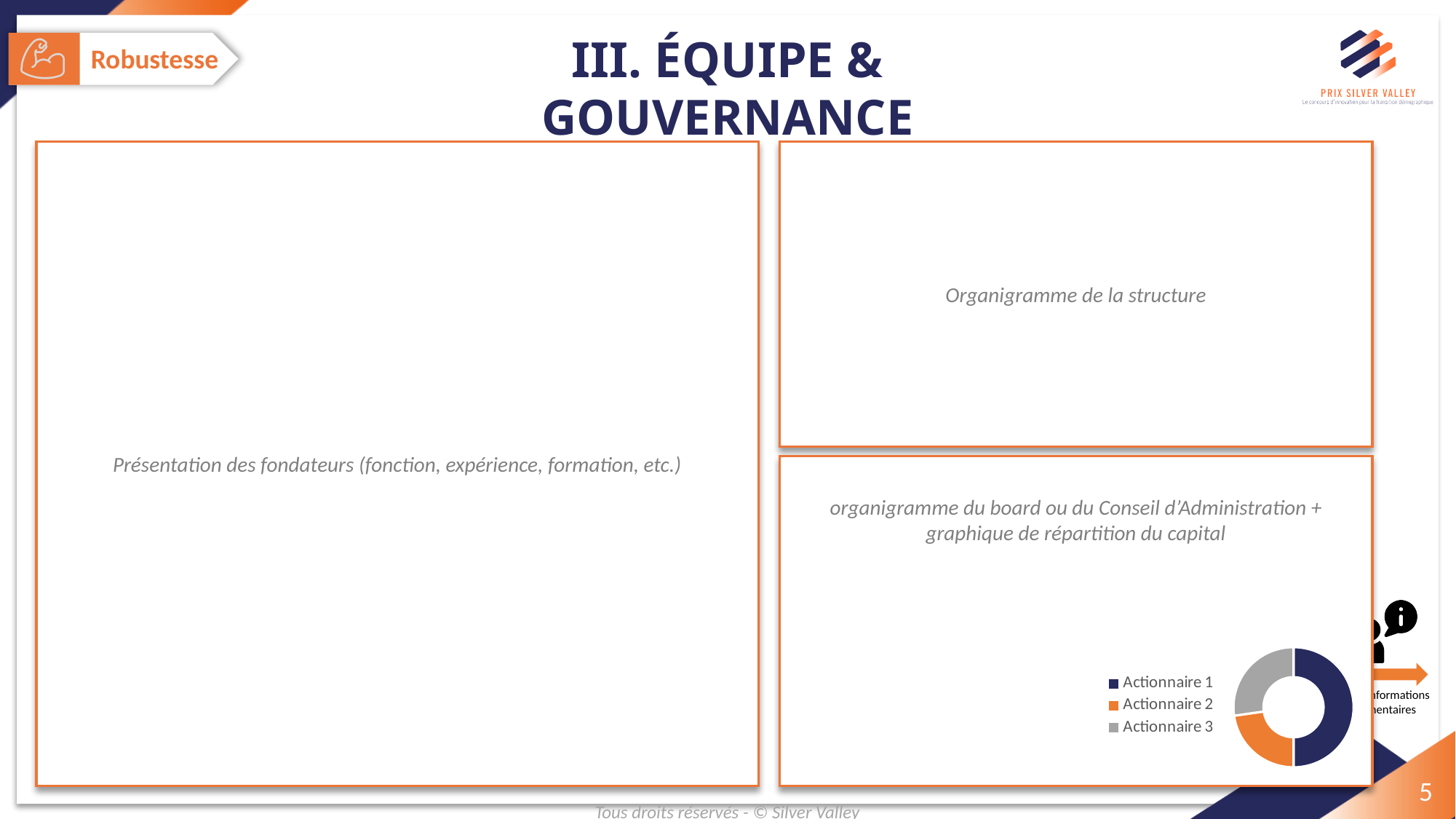
Which shareholder has the largest slice in the donut chart? Actionnaire 1 What kind of chart is shown in the bottom-right box of the slide? Pie chart (donut) Which legend entry of the donut chart is shown in grey? Actionnaire 3 How many slices does the donut chart have? 3 What colour represents Actionnaire 2 in the donut chart? Orange In the donut chart, which slice is larger: Actionnaire 2 or Actionnaire 3? Actionnaire 3 Which shareholder has the smallest slice in the donut chart? Actionnaire 2 How many entries does the legend of the donut chart list? 3 In the donut chart, which slice is larger: Actionnaire 1 or Actionnaire 2? Actionnaire 1